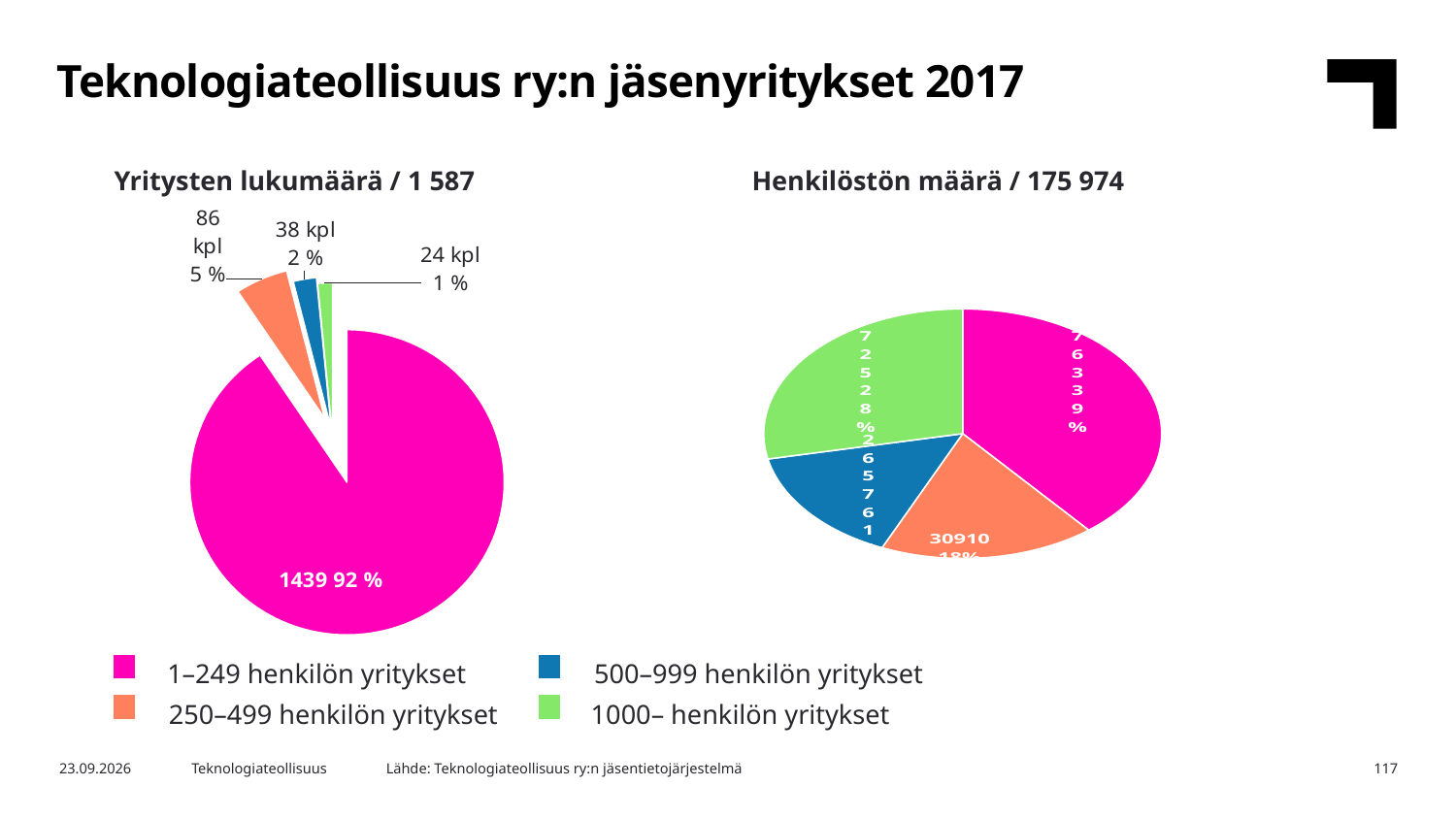
On the left chart (Yritysten lukumäärä / 1 587), how many companies are in the 1–249 henkilön yritykset category? 1439 What type of chart is used for Henkilöstön määrä / 175 974? Pie chart On the left chart (Yritysten lukumäärä / 1 587), how many companies are in the 250–499 henkilön yritykset category? 86 kpl On the left chart (Yritysten lukumäärä / 1 587), which category has the largest number of companies? 1–249 henkilön yritykset On the left chart (Yritysten lukumäärä / 1 587), which category has the smallest number of companies? 1000– henkilön yritykset On the left chart (Yritysten lukumäärä / 1 587), how many companies are in the 1000– henkilön yritykset category? 24 kpl On the left chart (Yritysten lukumäärä / 1 587), how many more companies are in the 250–499 category than in the 500–999 category? 48 On the left chart (Yritysten lukumäärä / 1 587), what share of companies are 500–999 henkilön yritykset? 2 % How many categories does the legend list for the charts? 4 On the left chart (Yritysten lukumäärä / 1 587), what share of companies are 1–249 henkilön yritykset? 92 % On the left chart (Yritysten lukumäärä / 1 587), which has more companies: 500–999 henkilön yritykset or 1000– henkilön yritykset? 500–999 henkilön yritykset On the right chart (Henkilöstön määrä / 175 974), what is the personnel count for the 250–499 henkilön yritykset slice? 30910